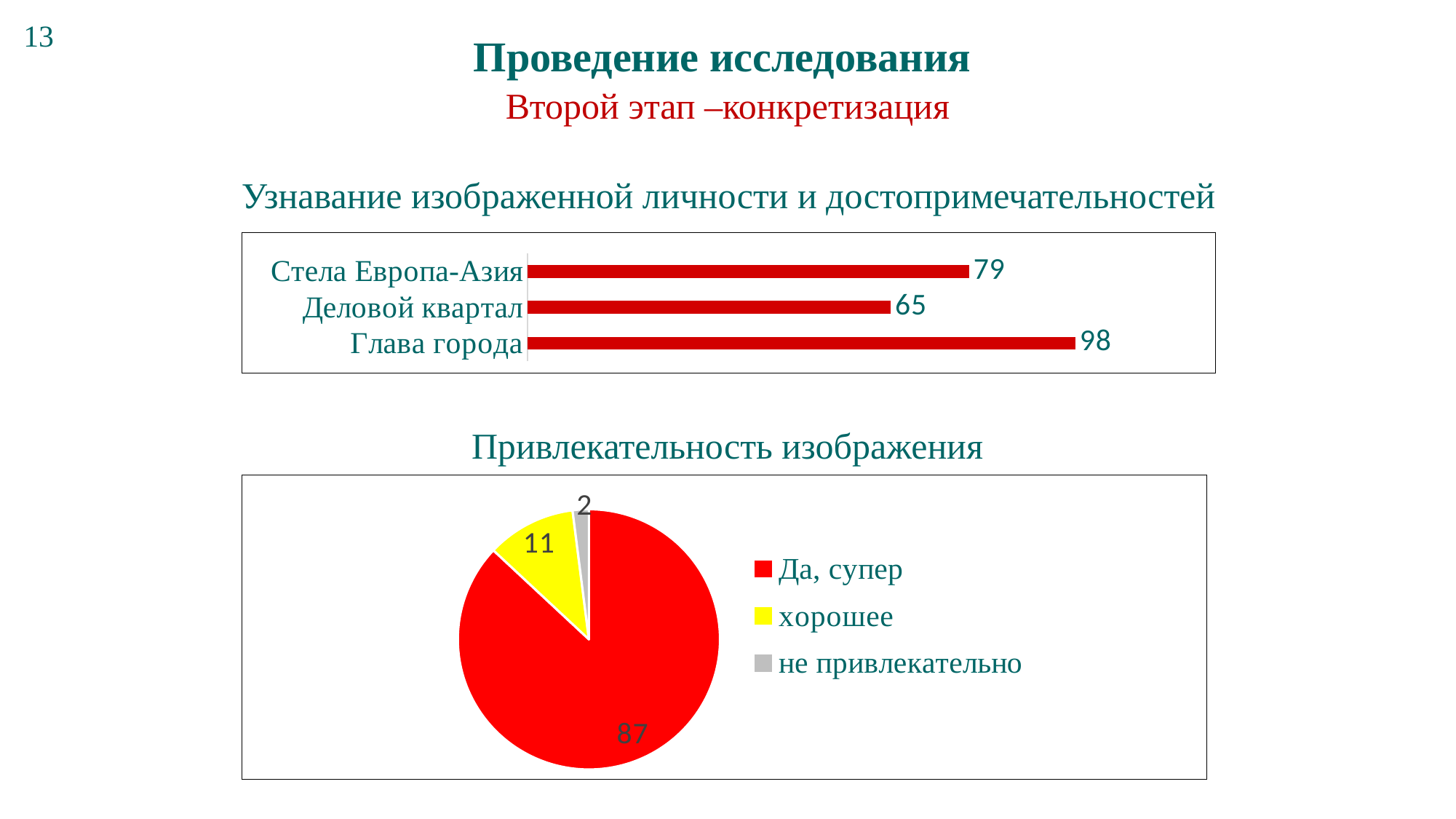
In the pie chart 'Привлекательность изображения', what colour is the slice for 'хорошее'? yellow In the bar chart 'Узнавание изображенной личности и достопримечательностей', what is the value for Глава города? 98 In the pie chart 'Привлекательность изображения', what is the value for 'Да, супер'? 87 In the bar chart 'Узнавание изображенной личности и достопримечательностей', which category has the highest value? Глава города In the bar chart 'Узнавание изображенной личности и достопримечательностей', which category has the lowest value? Деловой квартал In the bar chart 'Узнавание изображенной личности и достопримечательностей', what is the value for Деловой квартал? 65 What type of chart is the top chart 'Узнавание изображенной личности и достопримечательностей'? bar chart In the pie chart 'Привлекательность изображения', how many entries does the legend list? 3 In the bar chart 'Узнавание изображенной личности и достопримечательностей', what is the difference between the values for Глава города and Стела Европа-Азия? 19 In the pie chart 'Привлекательность изображения', what is the value for 'не привлекательно'? 2 In the bar chart 'Узнавание изображенной личности и достопримечательностей', how many categories are shown? 3 In the pie chart 'Привлекательность изображения', which slice is the largest? Да, супер